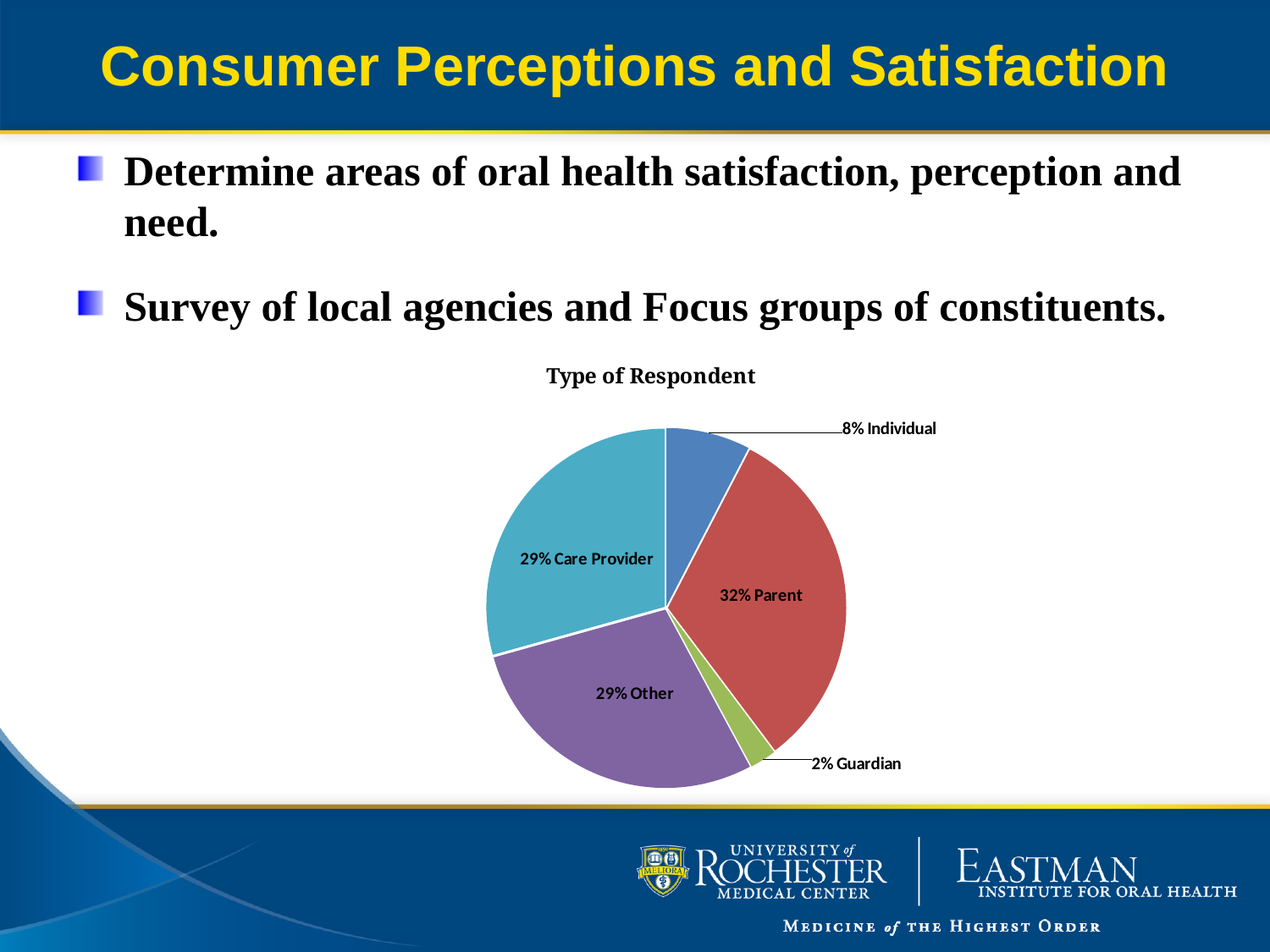
How many slices does the pie chart have? 5 What is the difference in percentage points between the Parent and Individual shares? 24 Which is larger, the share for Individual or the share for Guardian? Individual What share of respondents are Care Providers? 29% Which respondent type has the smallest share of the pie? Guardian What share of respondents are Parents? 32% What share of respondents are Individuals? 8% What is the title of the chart? Type of Respondent What type of chart is shown on the slide? Pie chart What colour is the Parent slice? Red Which respondent type has the largest share of the pie? Parent